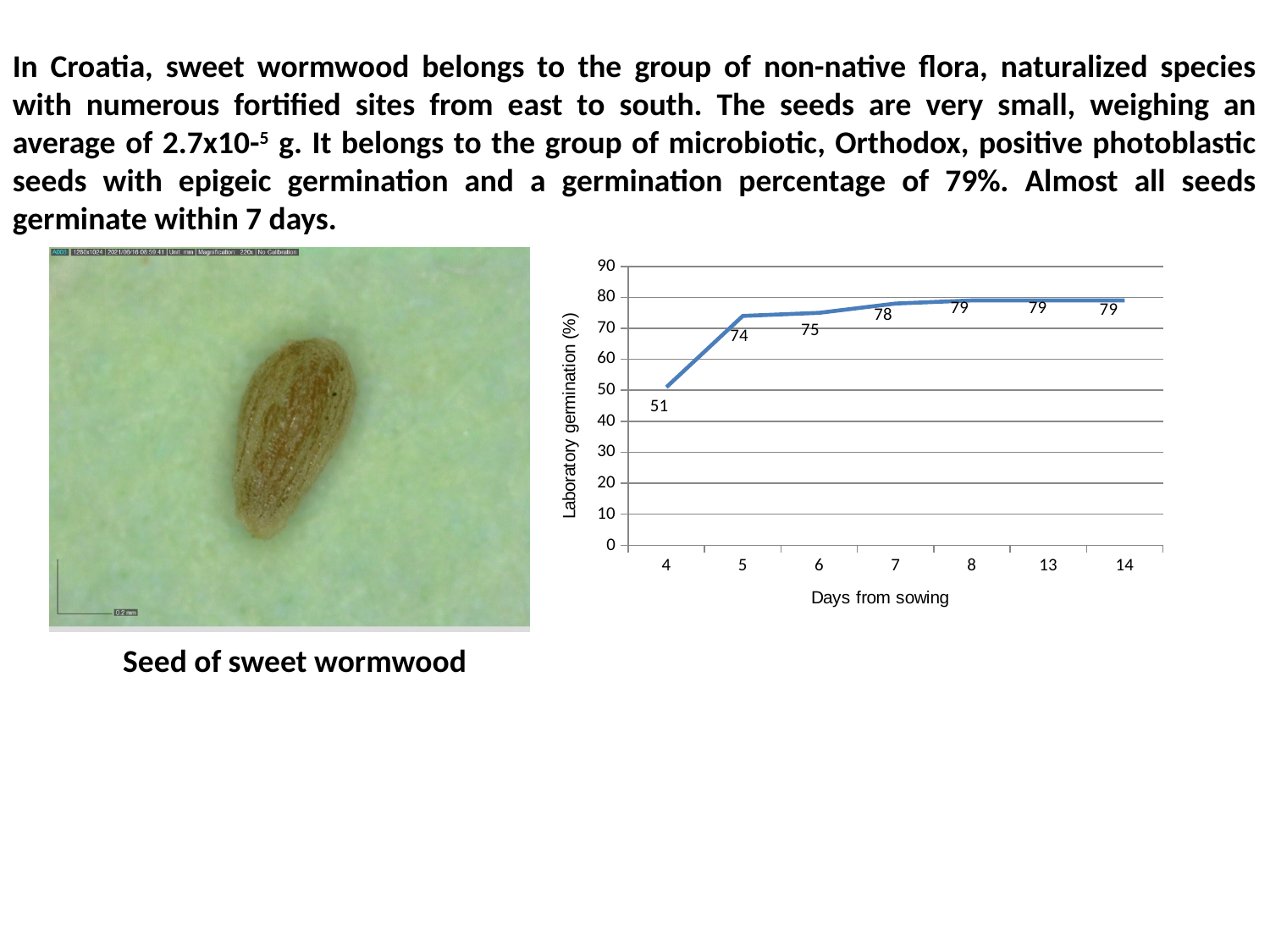
What is the difference in laboratory germination (%) between day 5 and day 4? 23 What is the laboratory germination (%) at 14 days from sowing? 79 How many data points are plotted on the line chart? 7 What is the laboratory germination (%) at 5 days from sowing? 74 What is the laboratory germination (%) at 4 days from sowing? 51 Does laboratory germination rise or fall as days from sowing increase? rise What is the difference in laboratory germination (%) between day 8 and day 6? 4 What kind of chart is shown on the slide? line chart At which number of days from sowing is the laboratory germination lowest? 4 Which has a higher laboratory germination: day 6 or day 7? day 7 Is the laboratory germination at day 4 greater or less than 60? less What is the laboratory germination (%) at 7 days from sowing? 78